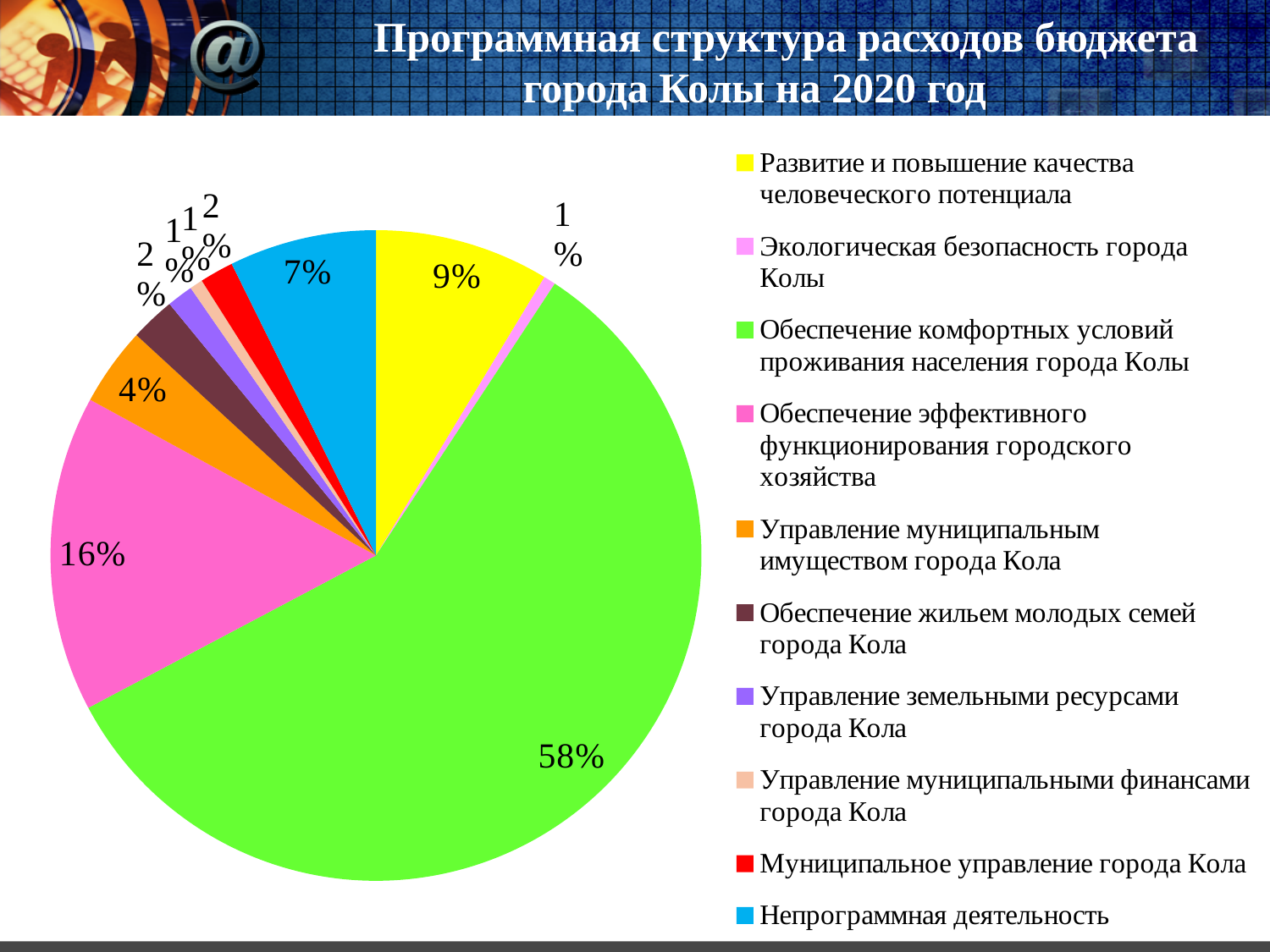
What colour is the slice for "Непрограммная деятельность"? blue What share of the budget goes to "Экологическая безопасность города Колы"? 1% What share of the budget goes to "Непрограммная деятельность"? 7% What share of the budget goes to "Обеспечение эффективного функционирования городского хозяйства"? 16% What share of the budget goes to "Обеспечение комфортных условий проживания населения города Колы"? 58% What share of the budget goes to "Развитие и повышение качества человеческого потенциала"? 9% Which is larger: the share for "Развитие и повышение качества человеческого потенциала" or the share for "Непрограммная деятельность"? Развитие и повышение качества человеческого потенциала Which category has the largest share of the pie? Обеспечение комфортных условий проживания населения города Колы What share of the budget goes to "Управление муниципальным имуществом города Кола"? 4% What is the difference between the shares of "Обеспечение комфортных условий проживания населения города Колы" and "Обеспечение эффективного функционирования городского хозяйства"? 42% How many categories does the legend list? 10 What kind of chart is shown on the slide? pie chart